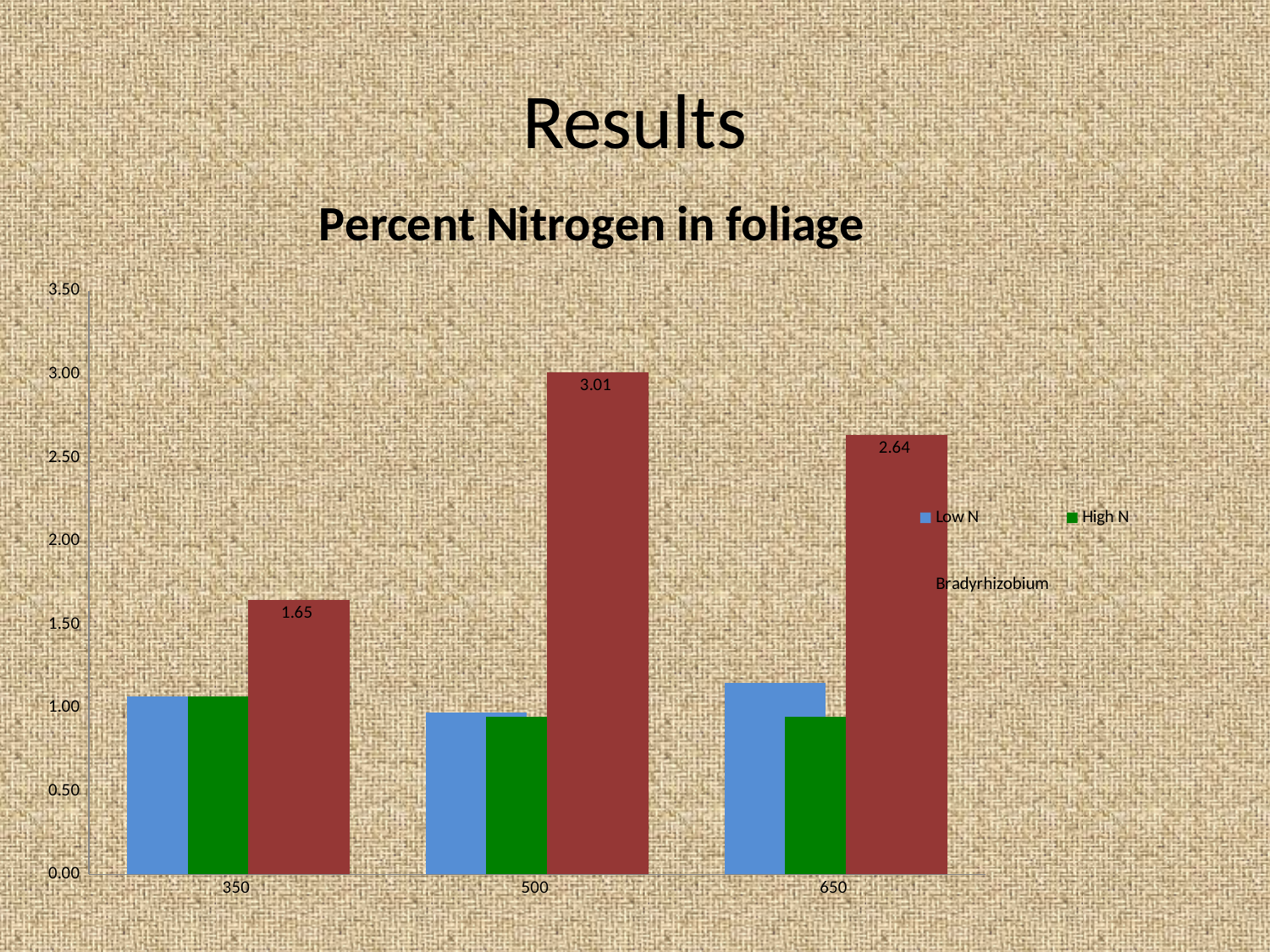
How many series does the legend list? 3 Is the value for High N at 650 greater or less than 1.00? less What kind of chart is shown on the slide? bar chart Which is larger, the Bradyrhizobium value at 650 or at 350? 650 At which category is the Bradyrhizobium value highest? 500 What is the difference between the Bradyrhizobium values at 500 and 350? 1.36 What is the value for Bradyrhizobium at 500? 3.01 At which category is the Bradyrhizobium value lowest? 350 What is the value for Bradyrhizobium at 350? 1.65 What is the value for Bradyrhizobium at 650? 2.64 How many categories are shown on the x axis? 3 Is the value for Low N at 650 greater or less than 1.00? greater